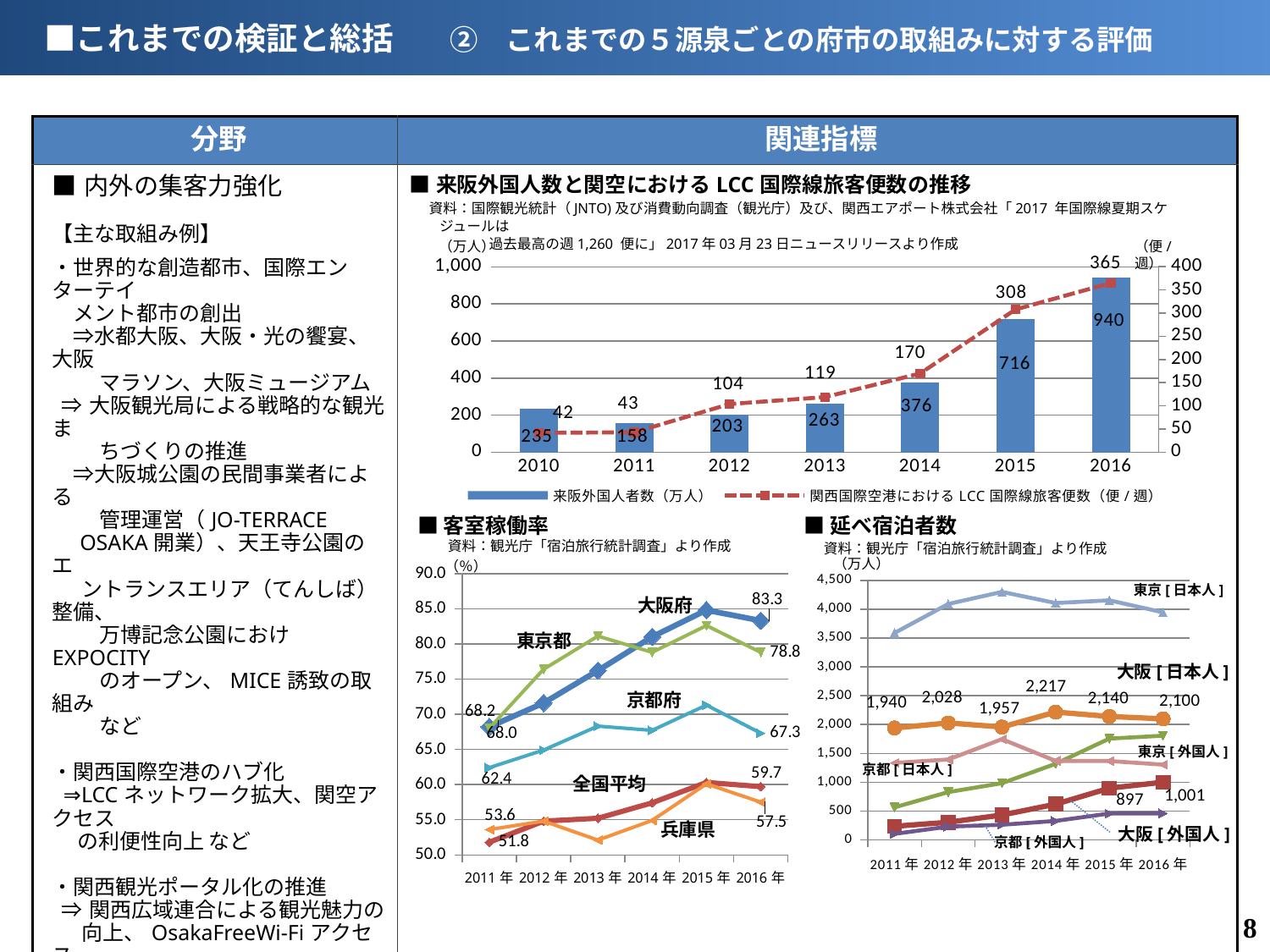
In the top chart (来阪外国人数と関空におけるLCC国際線旅客便数の推移), what is the value of 来阪外国人者数 for 2016? 940 In the top chart (来阪外国人数と関空におけるLCC国際線旅客便数の推移), which year has the lowest 来阪外国人者数? 2011 In the 客室稼働率 chart, which is larger in 2016年, 東京都 or 京都府? 東京都 In the top chart (来阪外国人数と関空におけるLCC国際線旅客便数の推移), what kind of chart is used for 来阪外国人者数? Bar chart In the top chart (来阪外国人数と関空におけるLCC国際線旅客便数の推移), what is the difference in 来阪外国人者数 between 2016 and 2015? 224 In the 客室稼働率 chart, what is the value for 全国平均 in 2011年? 51.8 In the top chart (来阪外国人数と関空におけるLCC国際線旅客便数の推移), how many years are shown on the x axis? 7 In the top chart (来阪外国人数と関空におけるLCC国際線旅客便数の推移), what is the LCC国際線旅客便数 value for 2015? 308 In the top chart (来阪外国人数と関空におけるLCC国際線旅客便数の推移), does the LCC国際線旅客便数 line rise or fall from 2012 to 2016? Rise In the 客室稼働率 chart, what is the value for 大阪府 in 2016年? 83.3 In the 延べ宿泊者数 chart, what is the value for 大阪[日本人] in 2014年? 2,217 In the 延べ宿泊者数 chart, what is the value for 大阪[外国人] in 2016年? 1,001